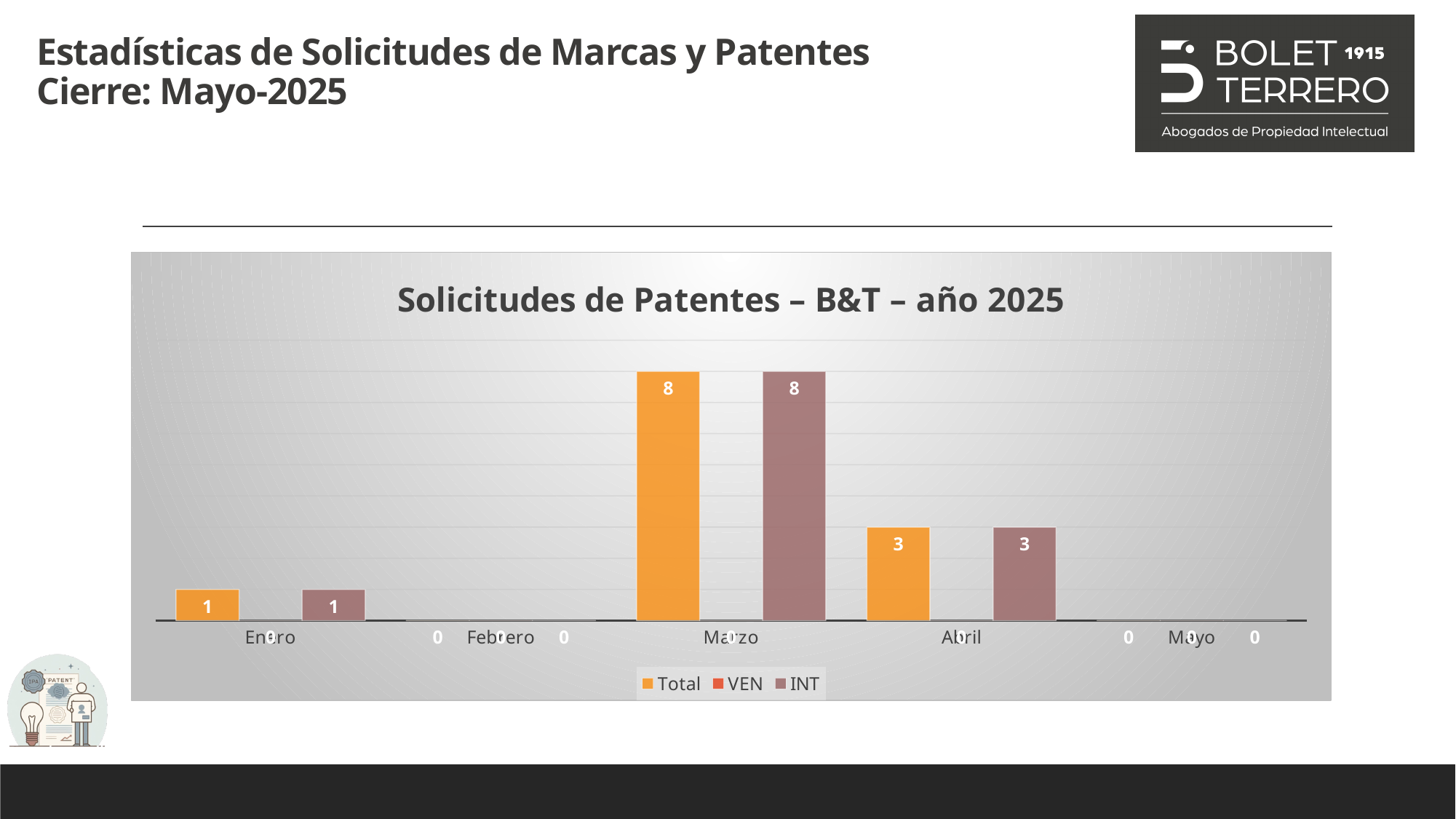
Which is larger, the INT value for Abril or the INT value for Enero? Abril What is the INT value for Abril? 3 Which month has the highest Total value? Marzo How many series does the chart legend list? 3 What is the Total value for Marzo? 8 What is the title of the chart? Solicitudes de Patentes – B&T – año 2025 Which series is shown in orange in the chart? Total How many months are shown on the x axis of the chart? 5 What type of chart is shown on the slide? bar chart What is the Total value for Enero? 1 What is the VEN value for Marzo? 0 What is the difference between the Total value for Marzo and the Total value for Abril? 5